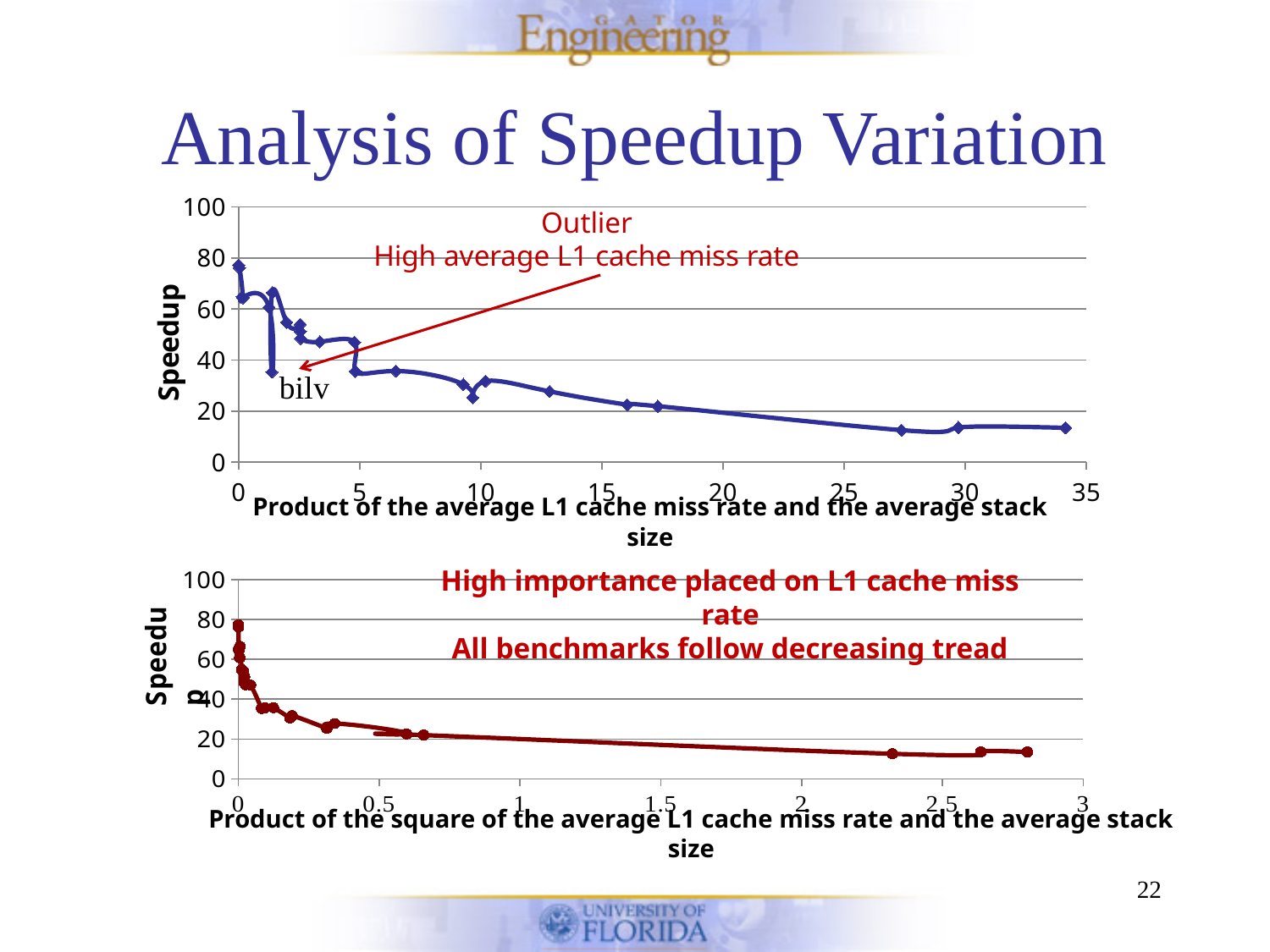
In the top chart, is the speedup of the leftmost point (at x = 0) greater or less than 60? greater In the top chart, do the speedup values generally rise or fall as the x-axis value increases? fall In the top chart, which point has the highest speedup: the leftmost point at x = 0 or the point labelled "bilv"? the leftmost point at x = 0 What kind of chart is the bottom chart on the slide? line chart In the top chart, is the speedup of the point labelled "bilv" greater or less than 40? less In the top chart, which benchmark is labelled as the outlier with a high average L1 cache miss rate? bilv In the bottom chart, do the speedup values generally rise or fall as the x-axis value increases? fall What kind of chart is the top chart on the slide? line chart What is the x-axis title of the top chart? Product of the average L1 cache miss rate and the average stack size In the bottom chart, is the speedup of the highest point (at x = 0) greater or less than 60? greater